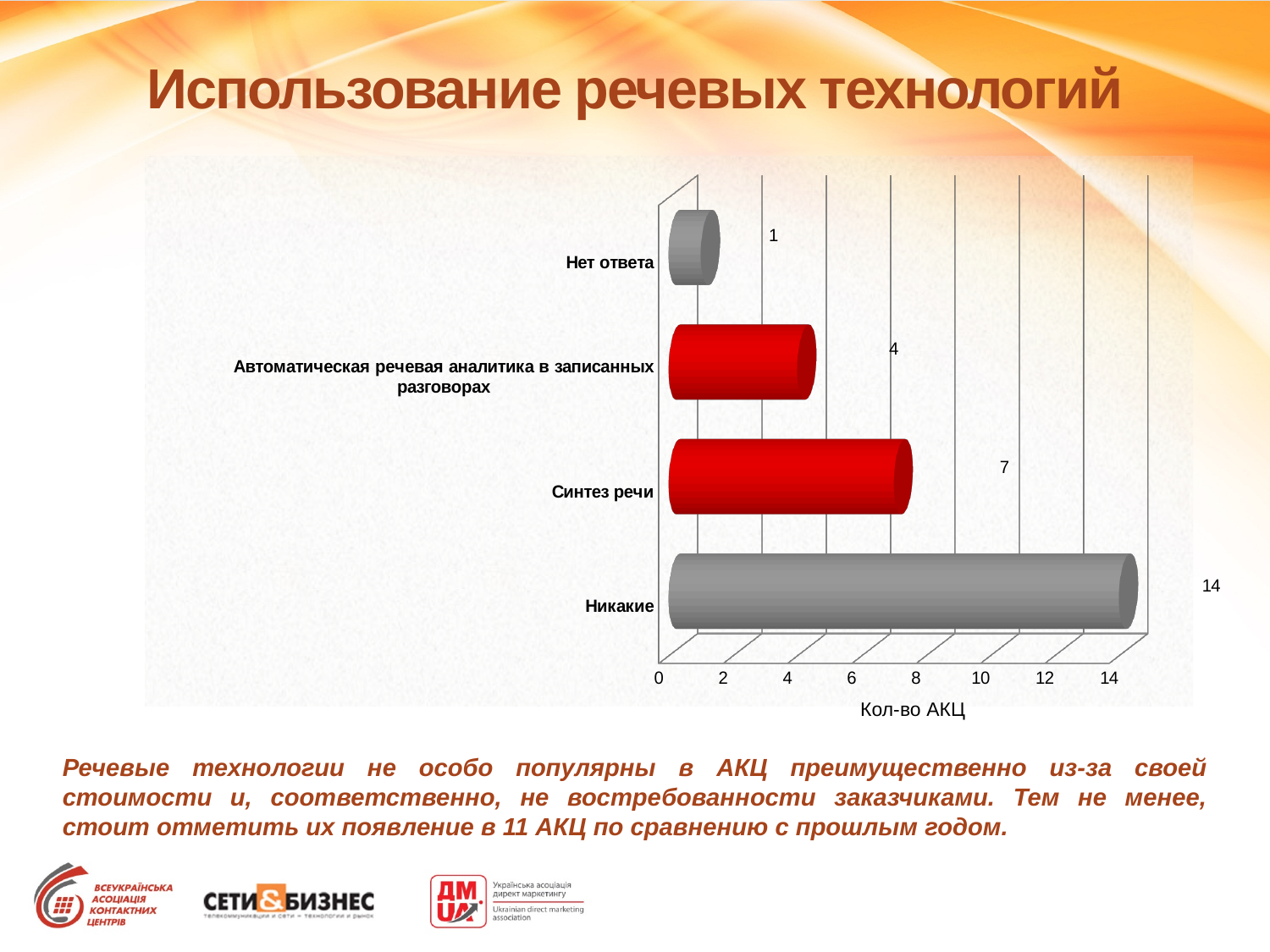
What is the label of the horizontal axis? Кол-во АКЦ What is the value for Никакие? 14 What is the difference between the values for Синтез речи and Автоматическая речевая аналитика в записанных разговорах? 3 What is the value for Нет ответа? 1 Which category has the highest value? Никакие How many categories are shown in the chart? 4 Which category has the lowest value? Нет ответа What is the difference between the values for Никакие and Синтез речи? 7 What is the value for Синтез речи? 7 Which is larger, the value for Синтез речи or the value for Автоматическая речевая аналитика в записанных разговорах? Синтез речи What is the value for Автоматическая речевая аналитика в записанных разговорах? 4 What kind of chart is shown on the slide? Bar chart